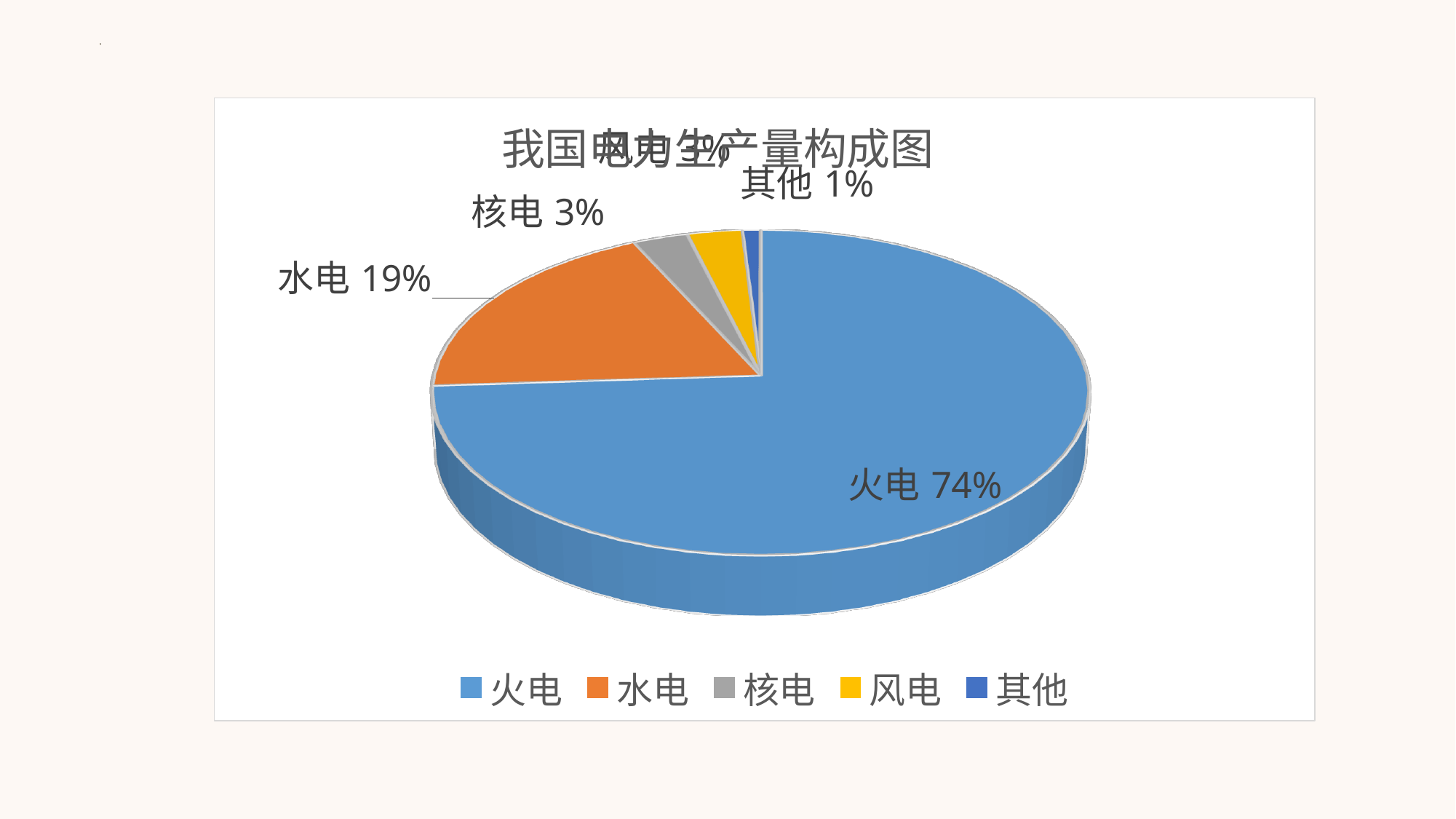
What share of the pie does 火电 have? 74% What share of the pie does 其他 have? 1% What kind of chart is shown on the slide? pie chart Which category has the largest slice of the pie? 火电 What is the difference between the shares of 水电 and 核电? 16% Which category has the smallest slice of the pie? 其他 Which is larger, the share for 水电 or the share for 核电? 水电 What share of the pie does 水电 have? 19% What colour represents 水电 in the pie chart? orange How many categories does the legend list? 5 What share of the pie does 核电 have? 3% What is the difference between the shares of 火电 and 水电? 55%